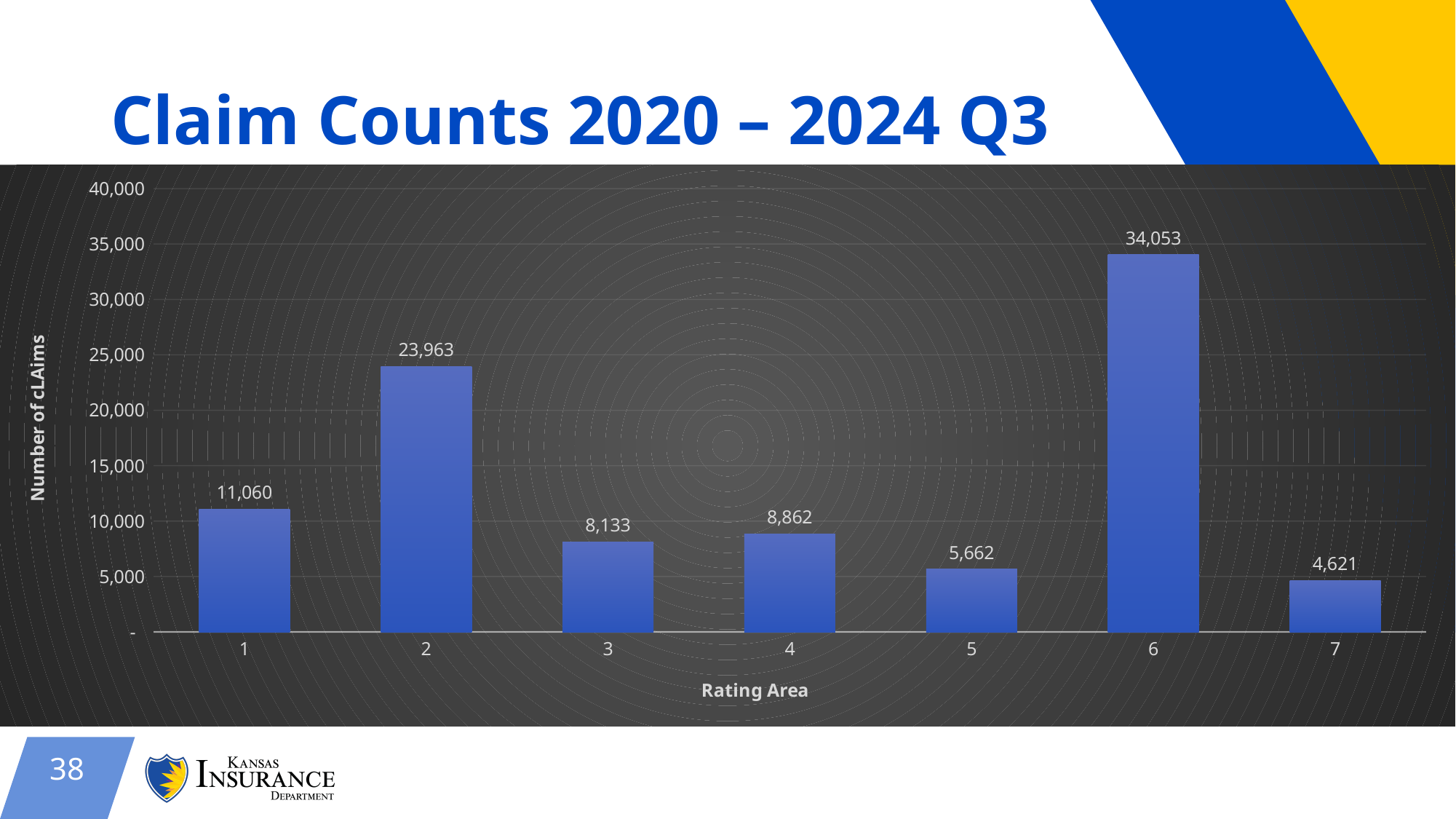
How many rating areas are shown on the chart? 7 What is the number of claims for Rating Area 4? 8,862 What is the number of claims for Rating Area 1? 11,060 What is the label of the x axis? Rating Area Which has more claims, Rating Area 1 or Rating Area 5? Rating Area 1 Is the value for Rating Area 2 greater or less than 20,000? greater What kind of chart is shown on the slide? bar chart What is the difference in claim counts between Rating Area 6 and Rating Area 2? 10,090 What is the number of claims for Rating Area 6? 34,053 What is the difference in claim counts between Rating Area 4 and Rating Area 3? 729 Which rating area has the lowest number of claims? 7 Which rating area has the highest number of claims? 6